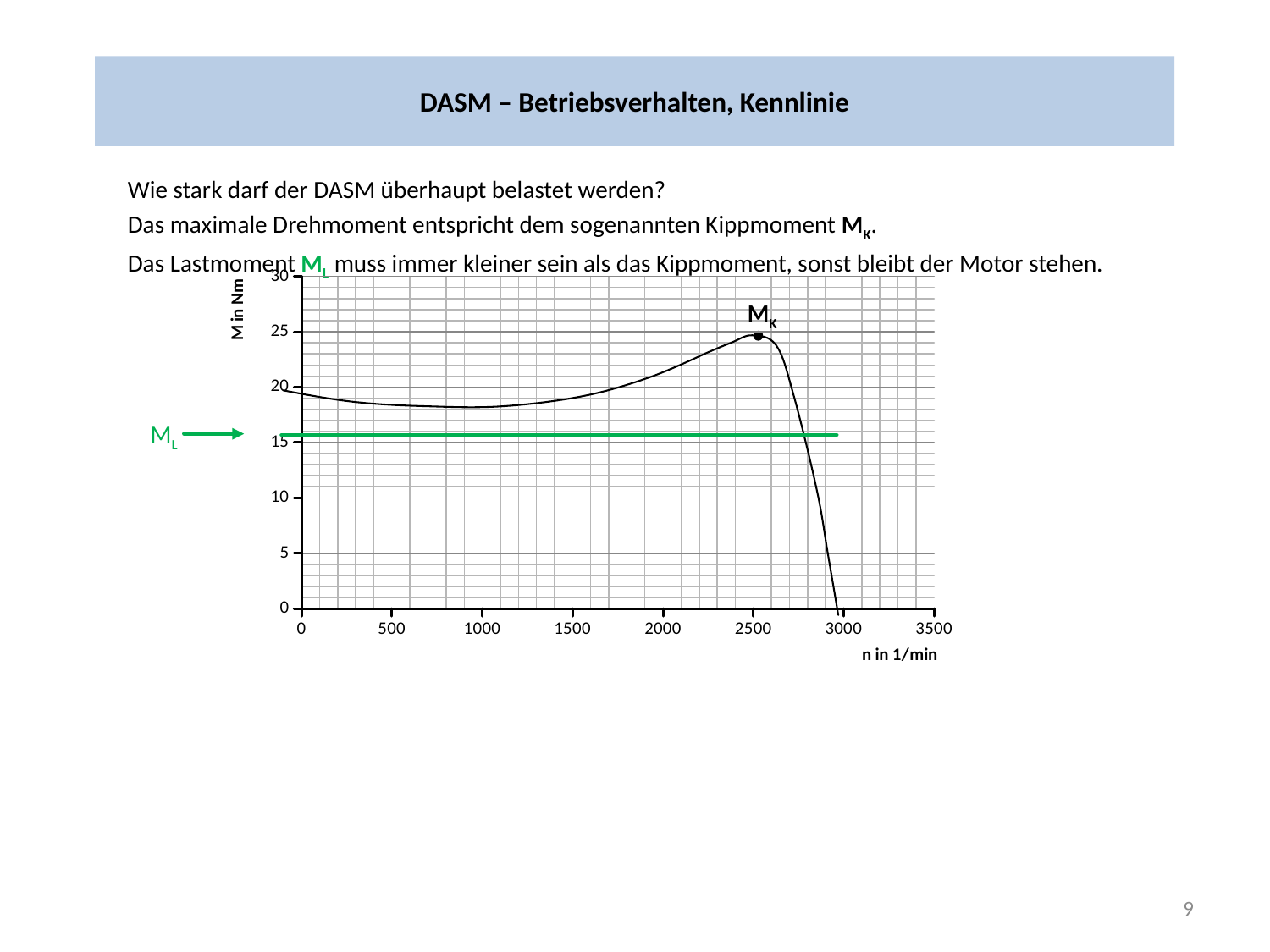
Is the torque at the point marked M_K greater or less than 30? less Which is larger, the torque at M_K or the torque of the green line M_L? M_K Is the green horizontal line M_L greater or less than 20? less Is the torque at the point marked M_K greater or less than 20? greater Between n = 2500 and n = 3000, does the curve rise or fall? fall Between n = 1000 and n = 2500, does the curve rise or fall? rise What is the label of the y axis of the chart? M in Nm What is the label of the x axis of the chart? n in 1/min What kind of chart is shown on the slide? line chart